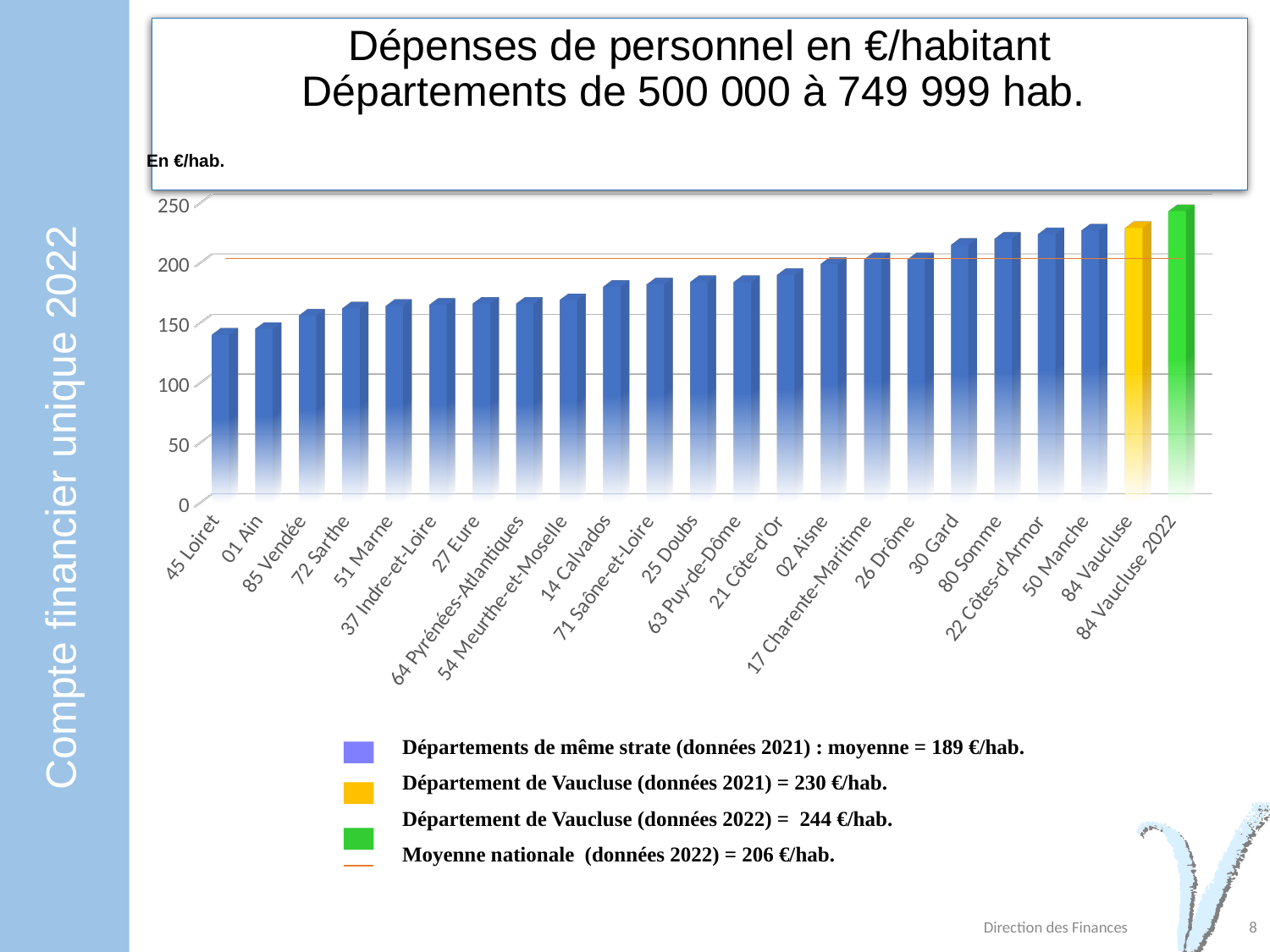
Which is larger, the value for 50 Manche or the value for 01 Ain? 50 Manche According to the legend text, what is the value for Département de Vaucluse (données 2021)? 230 €/hab. Which category has the highest value in the chart? 84 Vaucluse 2022 Is the value for 25 Doubs greater or less than 200? less Is the value for 45 Loiret greater or less than 150? less Do the values rise or fall from left to right along the x axis? rise According to the legend text, what is the value for Département de Vaucluse (données 2022)? 244 €/hab. Which category has the lowest value in the chart? 45 Loiret What is the difference between the Vaucluse 2022 value and the Vaucluse 2021 value? 14 €/hab. What kind of chart is shown on the slide? bar chart Is the value for 30 Gard greater or less than 200? greater How many bars are plotted in the chart? 23